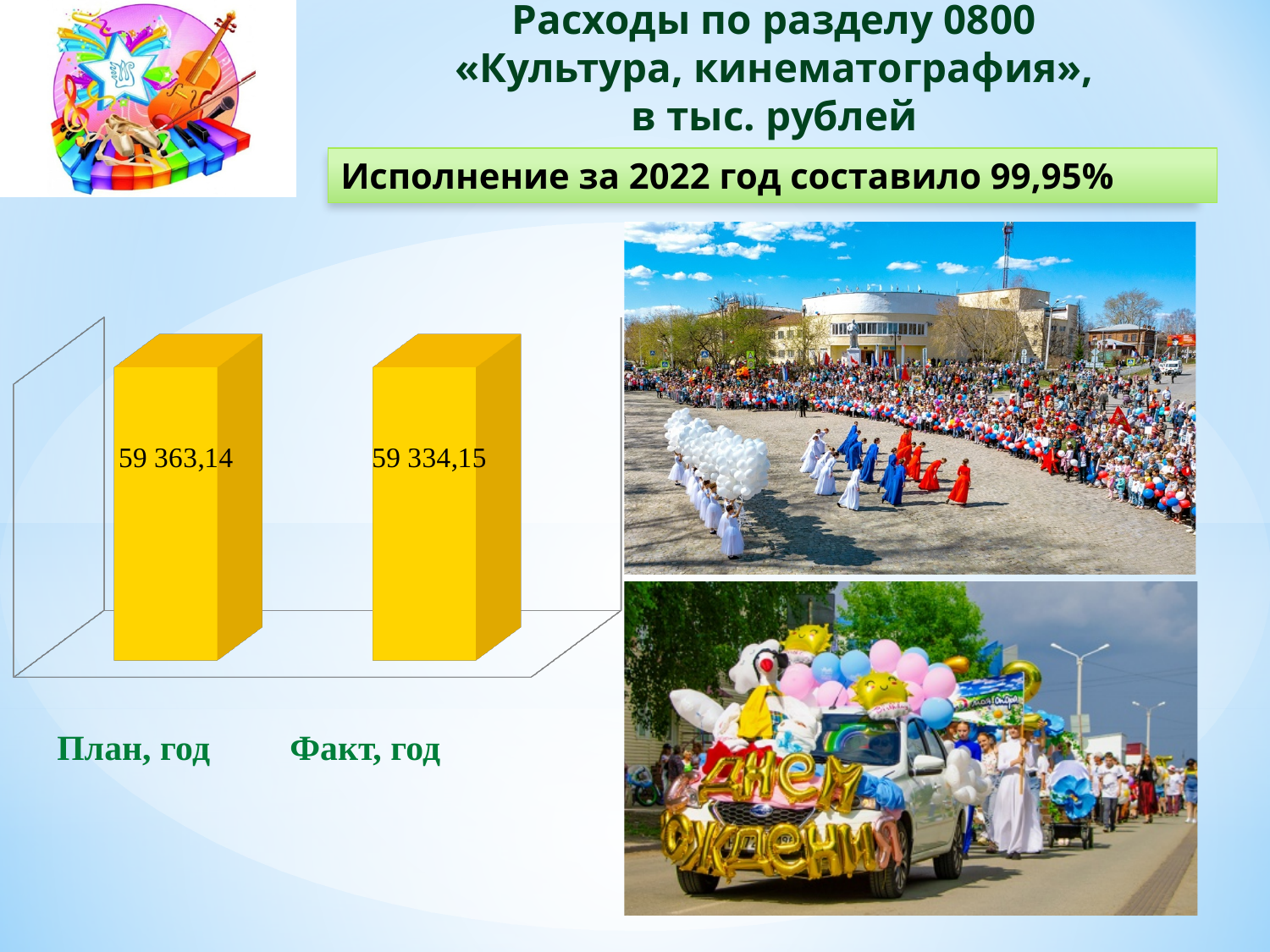
What is the difference between the values for План, год and Факт, год? 28,99 What is the value for Факт, год? 59 334,15 Which category has the highest value? План, год What execution percentage for 2022 is stated on the slide? 99,95% Do the values fall or rise from План, год to Факт, год? fall What colour are the bars in the chart? yellow What kind of chart is shown on the slide? bar chart Which category has the lowest value? Факт, год How many bars are shown in the chart? 2 Which category has the higher value, План, год or Факт, год? План, год What is the value for План, год? 59 363,14